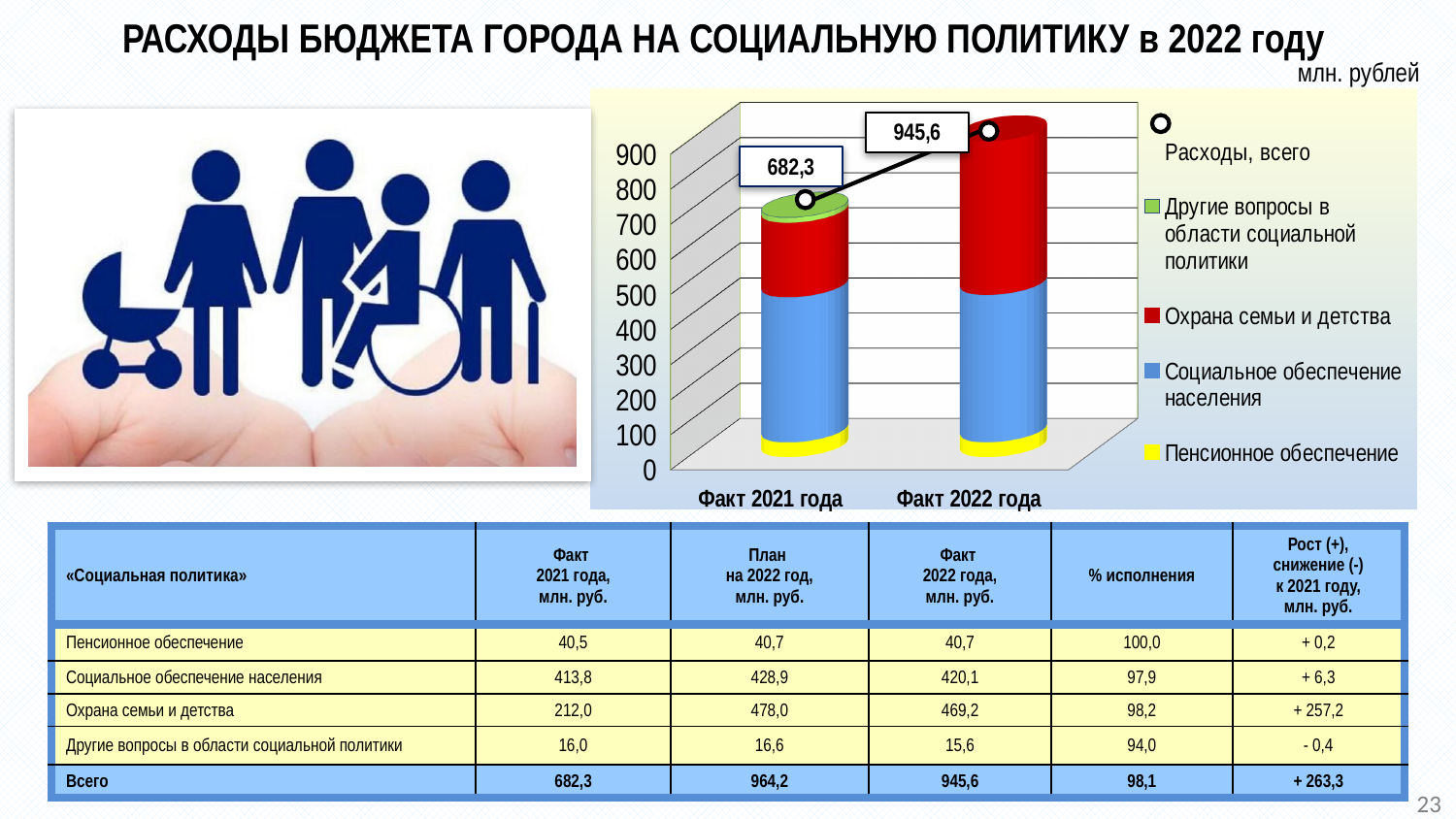
What is the value of «Расходы, всего» for Факт 2022 года? 945,6 What is the difference between the total expenditure for Факт 2022 года and Факт 2021 года? 263,3 What colour represents «Охрана семьи и детства» in the chart? red What is the value of «Расходы, всего» for Факт 2021 года? 682,3 Which category has the higher total expenditure («Расходы, всего»)? Факт 2022 года Which category has the lower total expenditure («Расходы, всего»)? Факт 2021 года How many categories are shown on the x axis of the chart? 2 How many entries does the chart legend list? 5 Is the total expenditure for Факт 2022 года greater or less than 900? greater What kind of chart is shown on the slide? bar chart Is the total expenditure for Факт 2021 года greater or less than 700? less Does the total expenditure rise or fall from Факт 2021 года to Факт 2022 года? rise